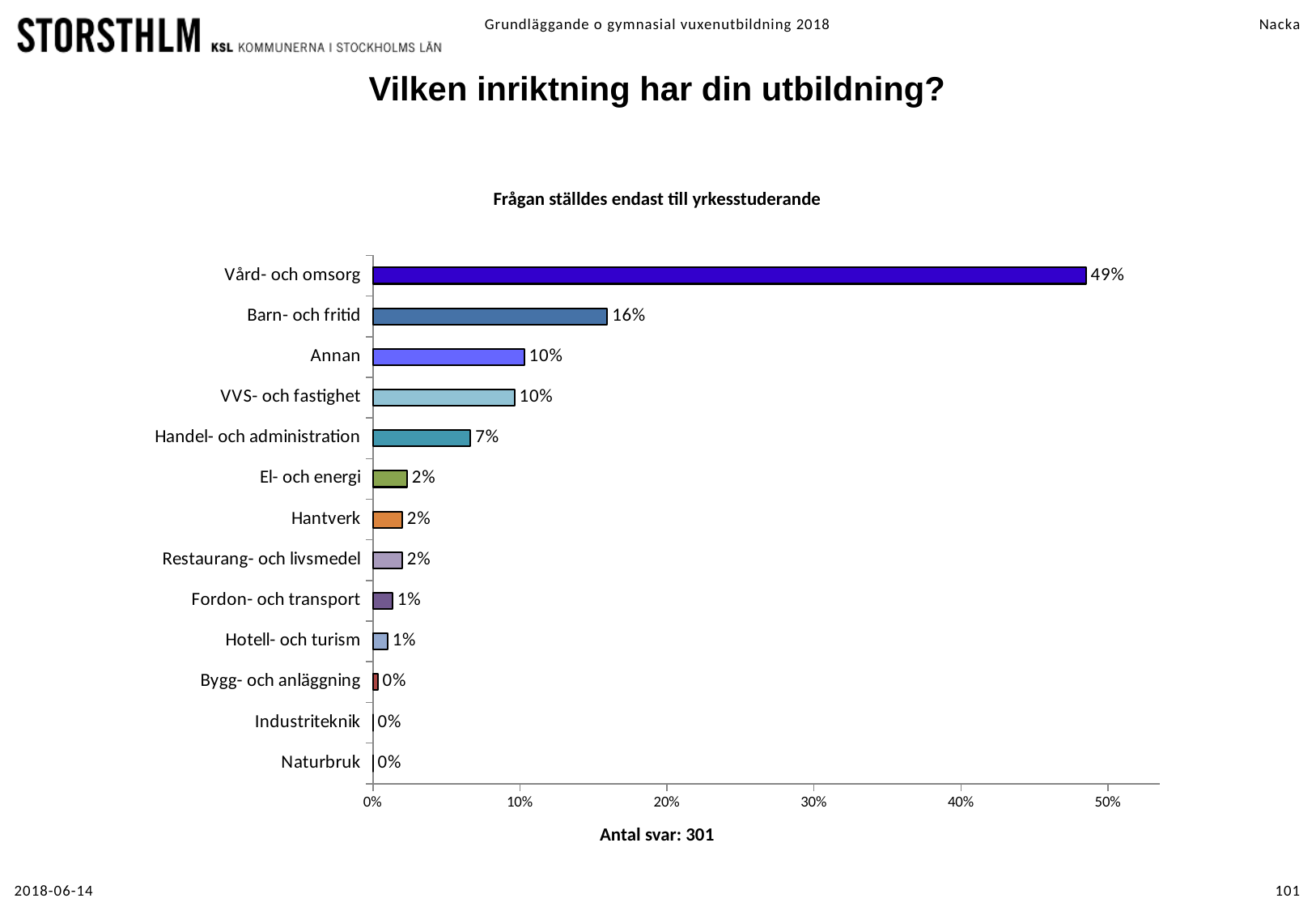
Is the value for Vård- och omsorg greater or less than 40%? greater What is the title of the slide? Vilken inriktning har din utbildning? What is the value for Handel- och administration? 7% What is the difference between the values for Vård- och omsorg and Barn- och fritid? 33% Which is larger, the value for Barn- och fritid or the value for Handel- och administration? Barn- och fritid What is the number of responses (Antal svar) shown below the chart? 301 How many categories are shown in the chart? 13 What is the value for Barn- och fritid? 16% Which category has the highest value? Vård- och omsorg What kind of chart is shown on the slide? bar chart What is the value for Fordon- och transport? 1% What is the value for Vård- och omsorg? 49%